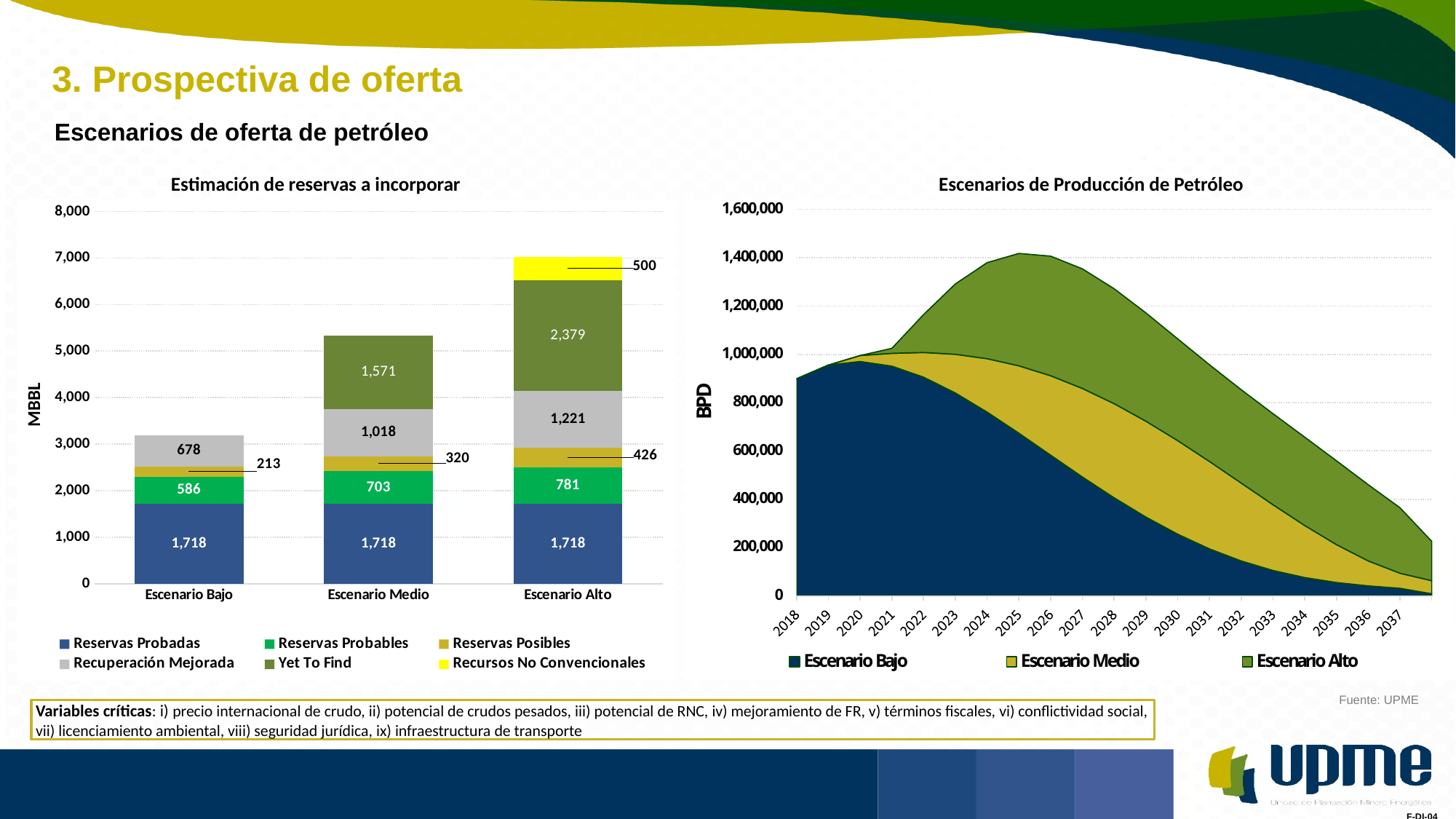
In the 'Estimación de reservas a incorporar' chart, which scenario has the highest Yet To Find value? Escenario Alto In the 'Estimación de reservas a incorporar' chart, what is the value of Reservas Probables for Escenario Medio? 703 In the 'Estimación de reservas a incorporar' chart, what is the difference between the Recuperación Mejorada values for Escenario Alto and Escenario Bajo? 543 In the 'Escenarios de Producción de Petróleo' chart, is the Escenario Alto value in 2025 greater or less than 1,200,000? greater What kind of chart is 'Escenarios de Producción de Petróleo'? Area chart How many years are shown on the x axis of the 'Escenarios de Producción de Petróleo' chart? 20 In the 'Estimación de reservas a incorporar' chart, what is the Yet To Find value for Escenario Alto? 2,379 How many series does the legend of the 'Estimación de reservas a incorporar' chart list? 6 How many series does the legend of the 'Escenarios de Producción de Petróleo' chart list? 3 In the 'Estimación de reservas a incorporar' chart, which has the larger Reservas Posibles value, Escenario Bajo or Escenario Medio? Escenario Medio In the 'Estimación de reservas a incorporar' chart, what is the total of the stacked bar for Escenario Bajo? 3,195 In the 'Estimación de reservas a incorporar' chart, what is the value of Recursos No Convencionales for Escenario Alto? 500